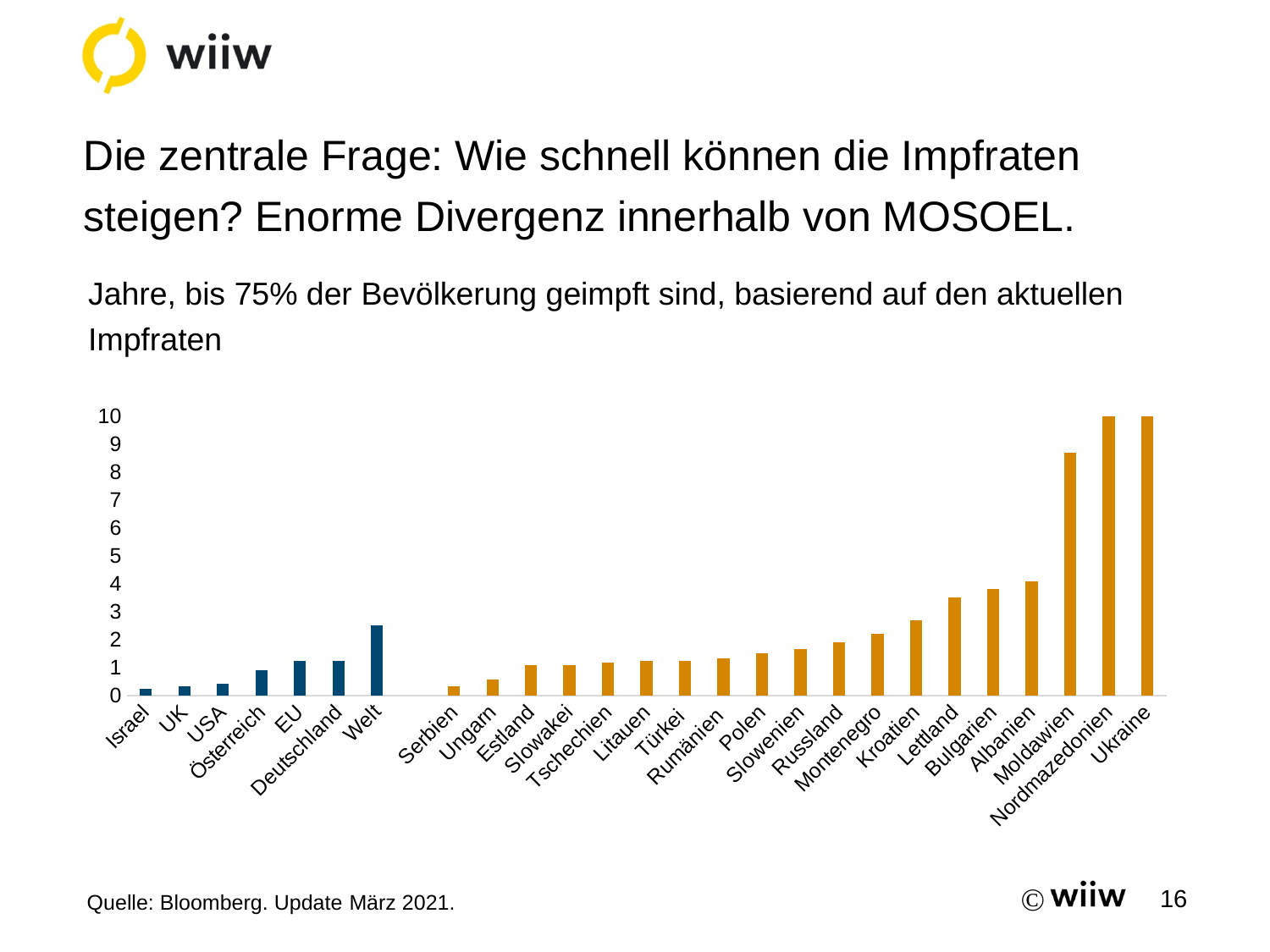
Do the values of the orange bars rise or fall from Serbien to Ukraine along the x axis? rise What source is cited below the chart? Bloomberg How many countries or regions are shown on the x axis of the chart? 26 What kind of chart is shown on the slide? bar chart Is the value for Ukraine greater or less than 9? greater Which has the larger value, Moldawien or Albanien? Moldawien Is the value for Lettland greater or less than 3? greater Is the value for Serbien greater or less than 1? less Which has the larger value, Welt or Deutschland? Welt